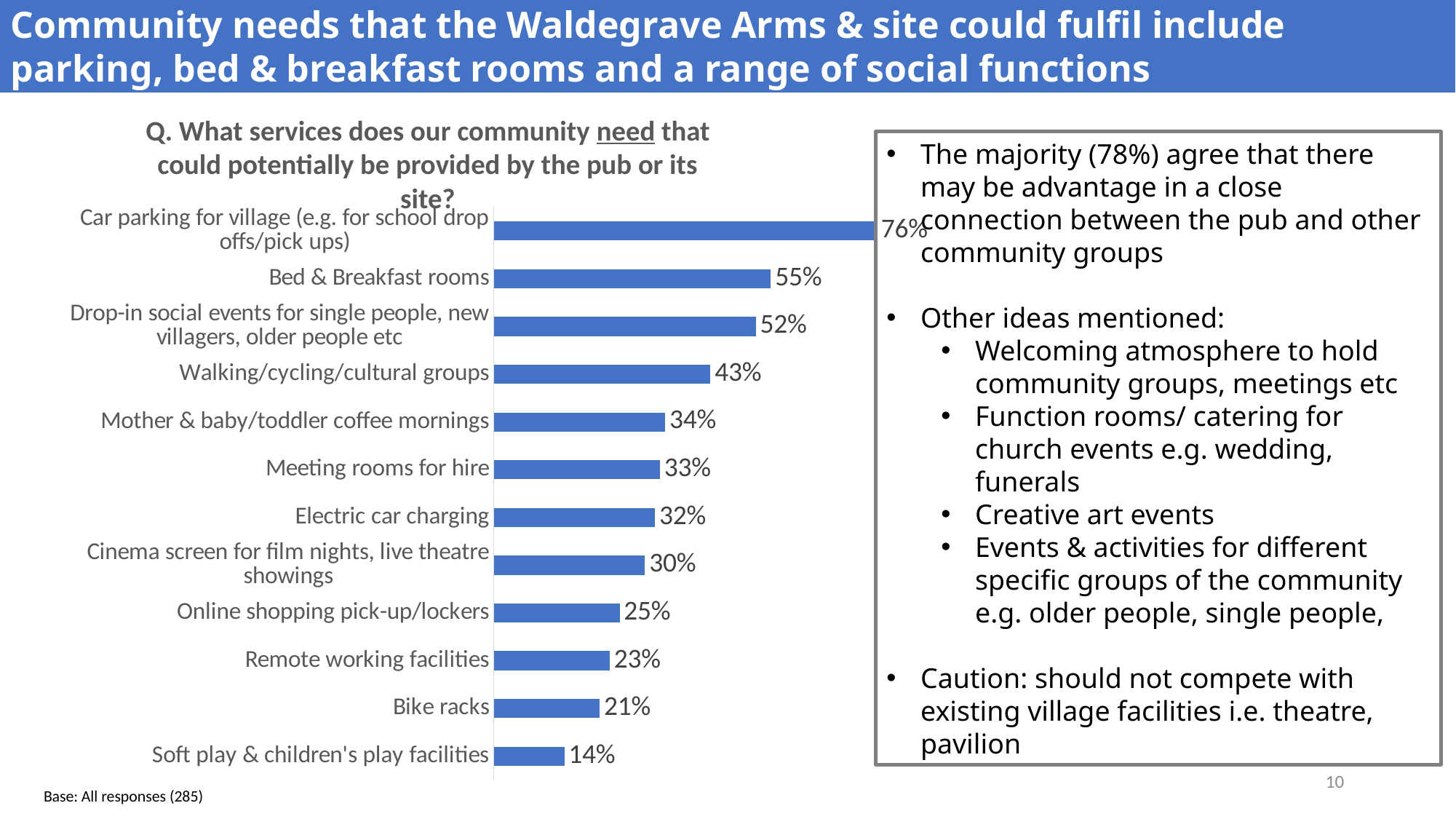
What percentage of respondents said the community needs bed & breakfast rooms? 55% How many services are listed in the chart? 12 What is the difference between the percentages for bed & breakfast rooms and drop-in social events? 3% What type of chart is used on this slide? Bar chart Which service has the lowest percentage in the chart? Soft play & children's play facilities What is the value shown for electric car charging? 32% Which has a higher percentage: meeting rooms for hire or online shopping pick-up/lockers? Meeting rooms for hire What is the difference between the percentages for walking/cycling/cultural groups and bike racks? 22% What percentage is shown for soft play & children's play facilities? 14% Which has a higher percentage: remote working facilities or mother & baby/toddler coffee mornings? Mother & baby/toddler coffee mornings Which service has the highest percentage in the chart? Car parking for village (e.g. for school drop offs/pick ups) What is the base (number of responses) stated for the chart? All responses (285)